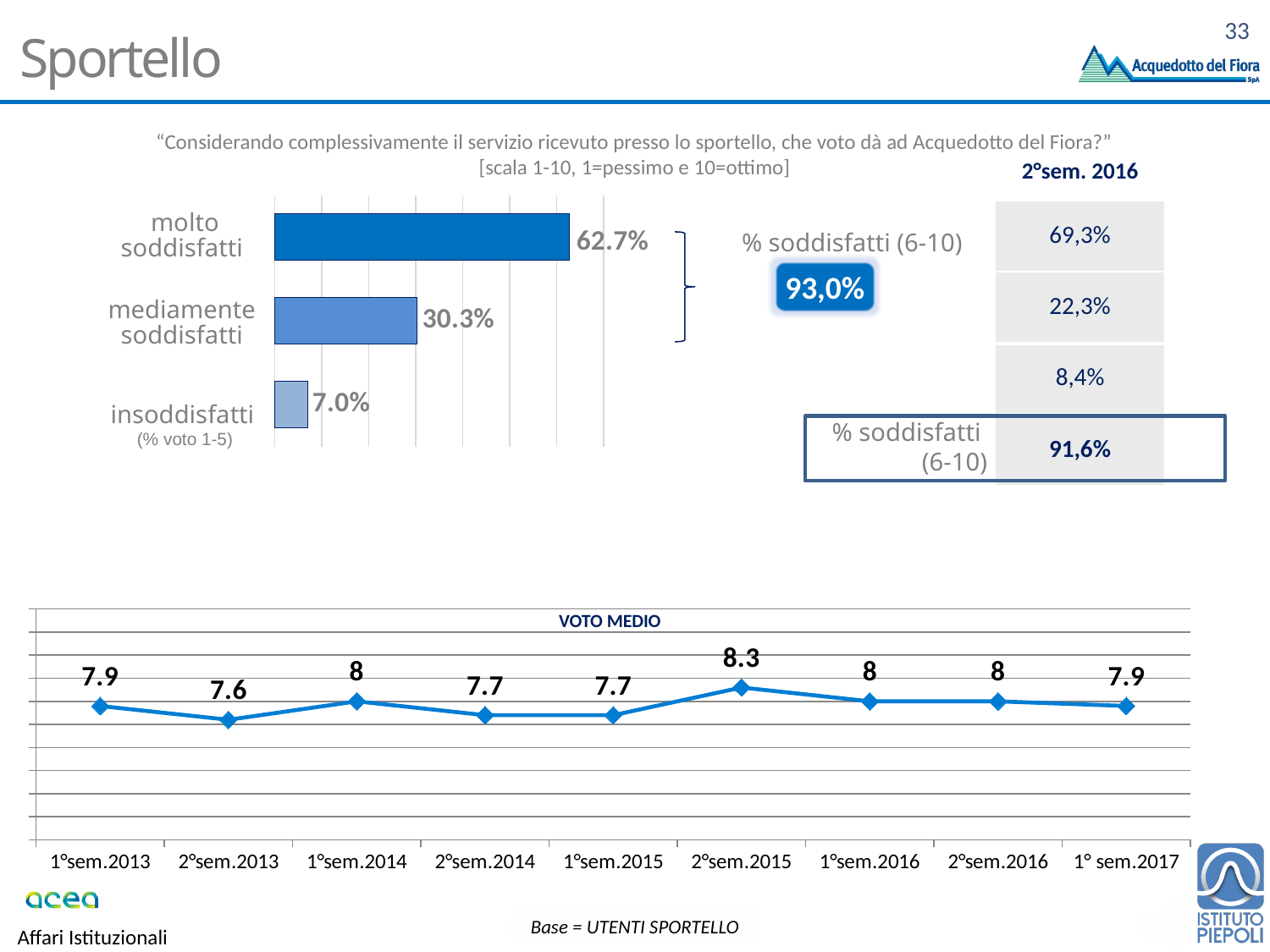
In the "VOTO MEDIO" chart, what is the value for 2°sem.2015? 8.3 What kind of chart is the chart at the top of the slide? bar chart In the "VOTO MEDIO" chart, which is larger: the value for 1°sem.2014 or the value for 2°sem.2014? 1°sem.2014 In the "VOTO MEDIO" chart, how many data points are plotted? 9 In the bar chart at the top of the slide, what is the value for "insoddisfatti"? 7.0% In the "VOTO MEDIO" chart, what is the value for 2°sem.2013? 7.6 In the bar chart at the top of the slide, how many categories are shown? 3 In the "VOTO MEDIO" chart, which period has the highest value? 2°sem.2015 In the bar chart at the top of the slide, which category has the lowest value? insoddisfatti In the bar chart at the top of the slide, which category has the highest value? molto soddisfatti In the bar chart at the top of the slide, what is the value for "molto soddisfatti"? 62.7% In the bar chart at the top of the slide, what is the difference between "molto soddisfatti" and "mediamente soddisfatti"? 32.4%